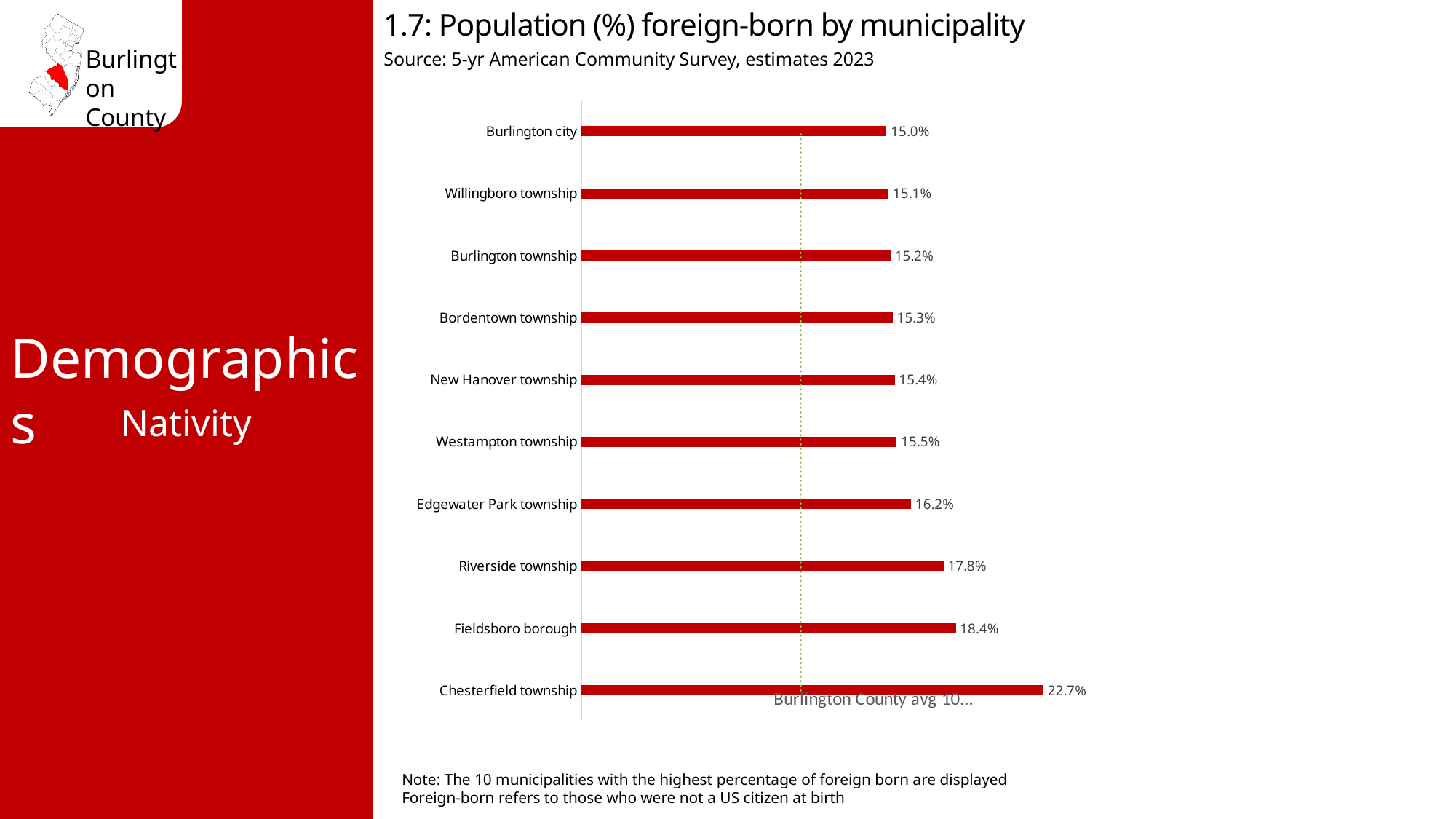
What type of chart is used to display the foreign-born population percentages? Bar chart What is the foreign-born population percentage for Burlington city? 15.0% Which has a higher foreign-born percentage, Fieldsboro borough or Edgewater Park township? Fieldsboro borough Which municipality has the lowest foreign-born population percentage shown on the chart? Burlington city What is the foreign-born population percentage for Chesterfield township? 22.7% What is the difference in foreign-born percentage between Riverside township and Westampton township? 2.3% What is the difference in foreign-born percentage between Chesterfield township and Fieldsboro borough? 4.3% What is the foreign-born population percentage for Riverside township? 17.8% How many municipalities are shown on the chart? 10 What is the source of the data shown in the chart? 5-yr American Community Survey, estimates 2023 Which municipality has the highest foreign-born population percentage? Chesterfield township What is the foreign-born population percentage for Edgewater Park township? 16.2%